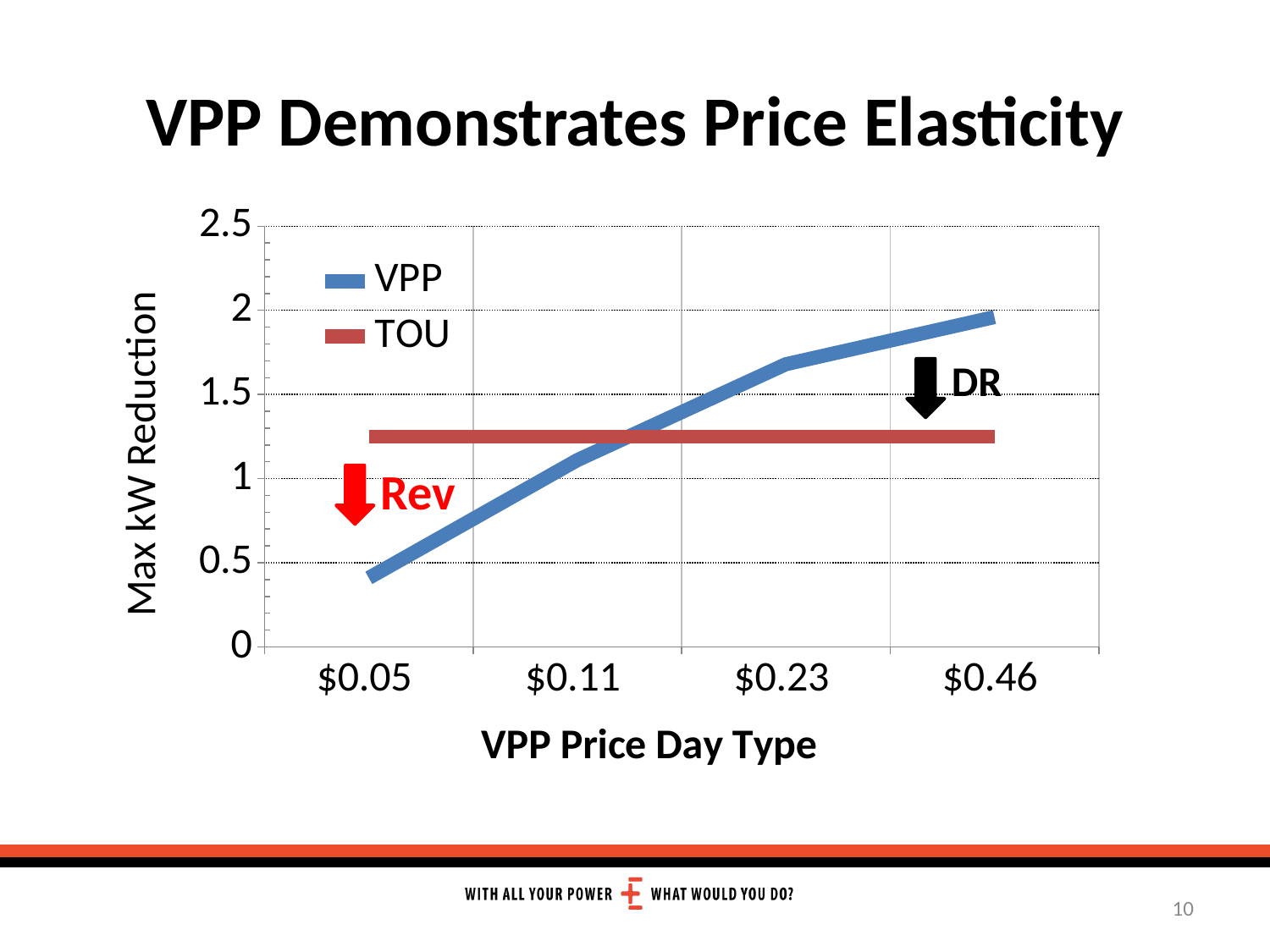
Is the TOU value greater or less than 1? greater At $0.46, which series has the larger value, VPP or TOU? VPP What kind of chart is shown on the slide? line chart How many VPP price day types are shown on the x axis? 4 Is the VPP value at $0.46 greater or less than 1.5? greater What is the label of the y axis? Max kW Reduction How many series does the legend list? 2 At which VPP price day type is the VPP line highest? $0.46 Is the VPP value at $0.05 greater or less than 0.5? less At $0.05, which series has the larger value, VPP or TOU? TOU Does the VPP line rise or fall as the VPP price increases along the x axis? rises